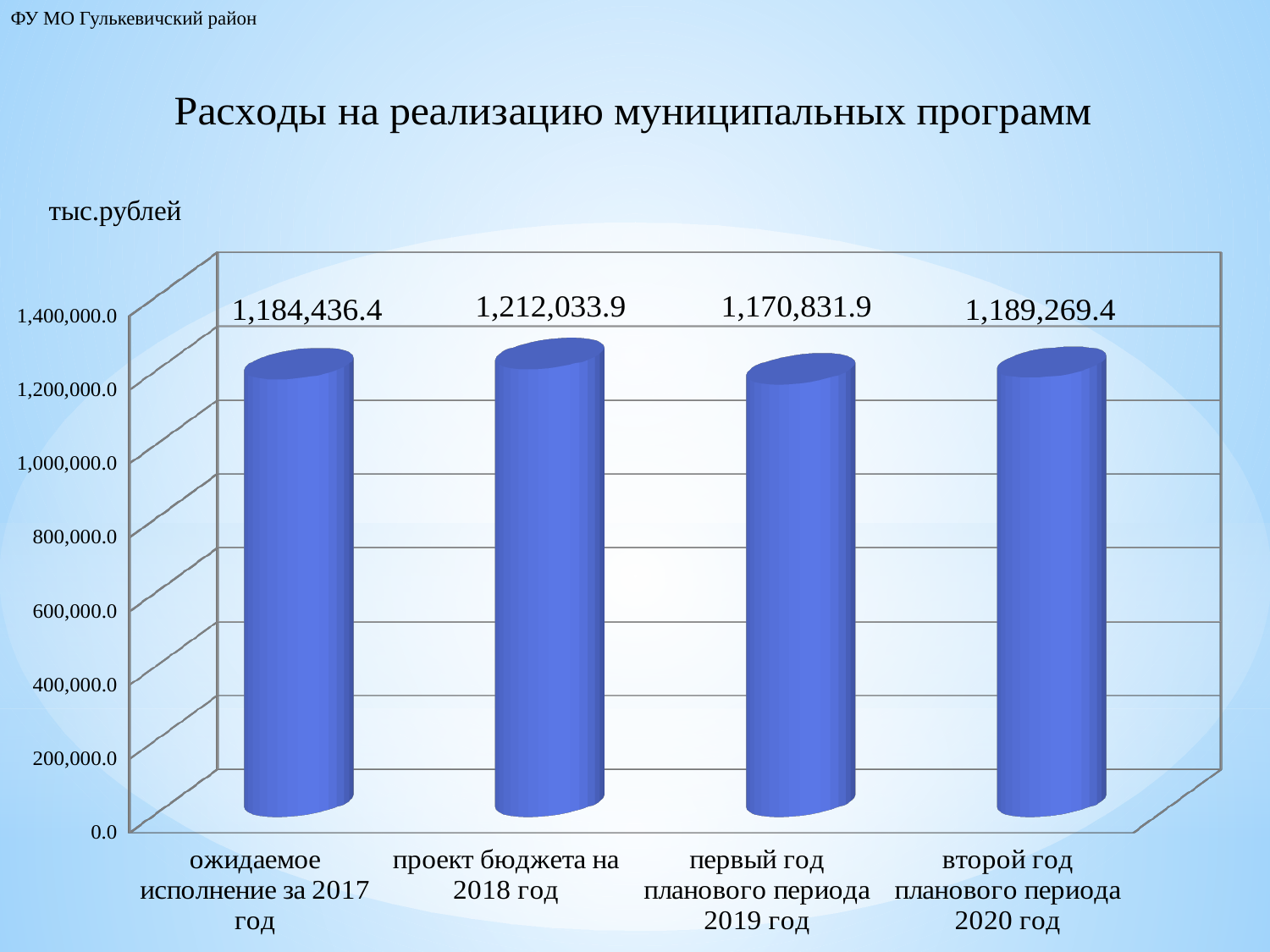
What is the value for «ожидаемое исполнение за 2017 год»? 1,184,436.4 Which category has the lowest value? первый год планового периода 2019 год What is the value for «первый год планового периода 2019 год»? 1,170,831.9 What is the difference between the value for 2020 (второй год планового периода) and the value for 2019 (первый год планового периода)? 18,437.5 What is the value for «второй год планового периода 2020 год»? 1,189,269.4 What is the value for «проект бюджета на 2018 год»? 1,212,033.9 Which category has the highest value? проект бюджета на 2018 год What kind of chart is shown on the slide? bar chart Which is larger: the value for 2017 (ожидаемое исполнение) or the value for 2020 (второй год планового периода)? второй год планового периода 2020 год What is the difference between the value for 2018 (проект бюджета) and the value for 2017 (ожидаемое исполнение)? 27,597.5 How many categories are shown on the chart? 4 Is the value for «первый год планового периода 2019 год» greater or less than 1,000,000.0? greater